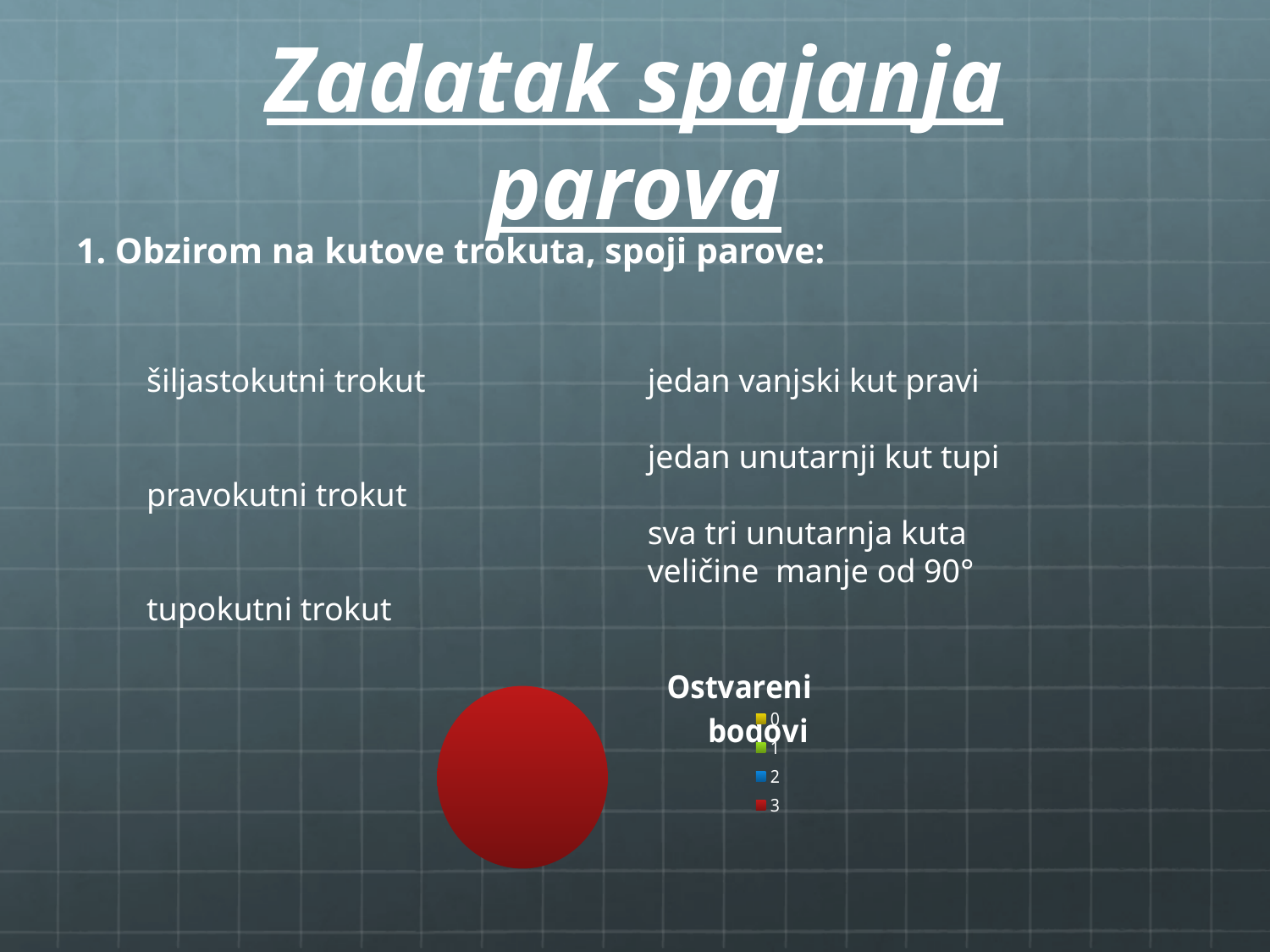
What kind of chart is shown on the slide? pie chart What colour is the legend entry for category 3? red Which category is larger in the pie, 3 or 0? 3 Which category is larger in the pie, 3 or 2? 3 How many entries does the chart's legend list? 4 What is the title of the chart on the slide? Ostvareni bodovi Which legend category takes up the largest share of the pie? 3